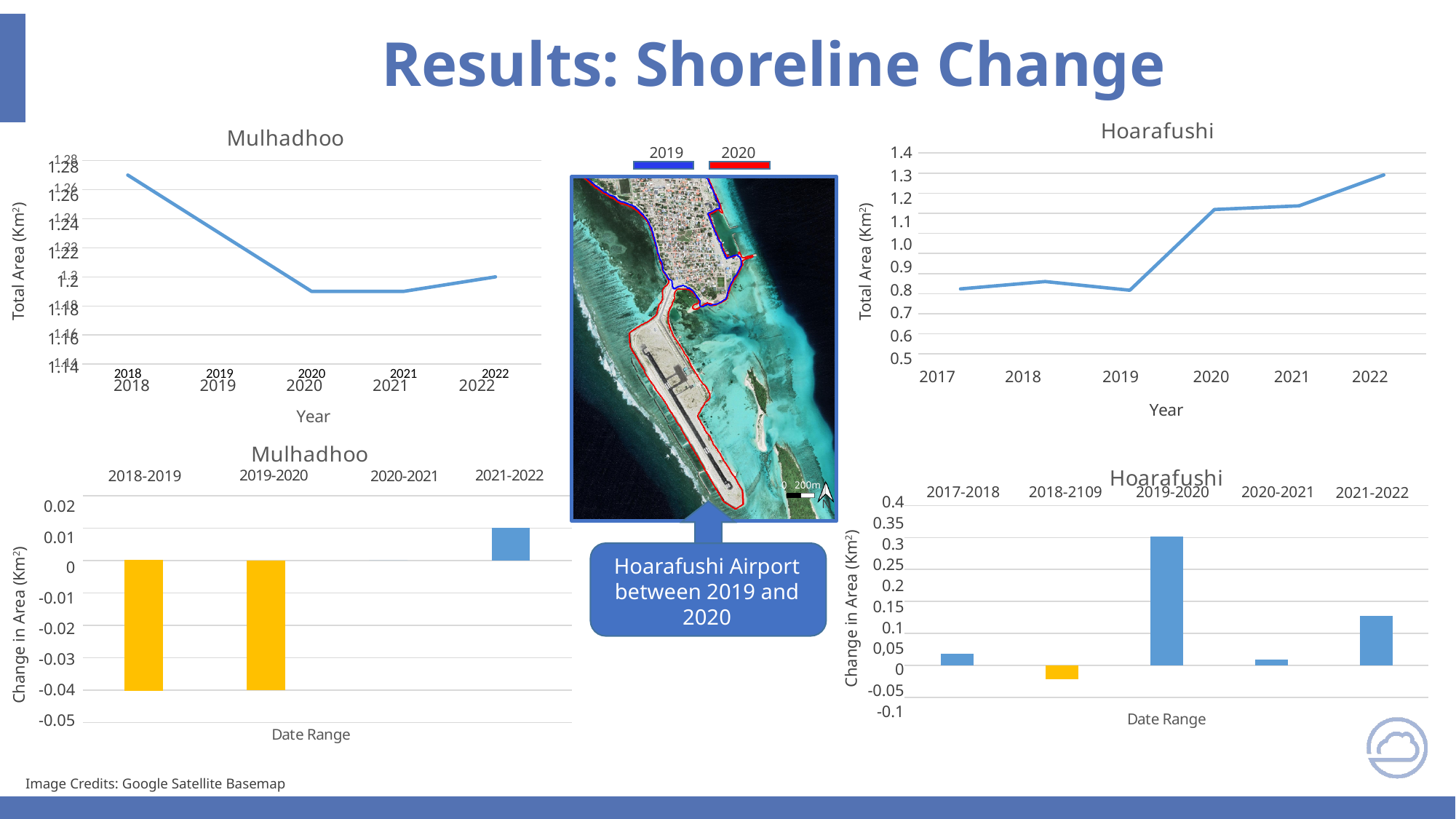
In the bottom-left Mulhadhoo bar chart, is the value for 2018-2019 greater or less than -0.03? less What kind of chart is the top-left Mulhadhoo chart? line chart In the bottom-right Hoarafushi bar chart, which date range has the highest change in area? 2019-2020 In the bottom-right Hoarafushi bar chart, which date range has the lowest change in area? 2018-2109 In the top-right Hoarafushi line chart, is the value for 2017 greater or less than 0.9? less In the top-left Mulhadhoo line chart, which year has the highest total area? 2018 In the bottom-left Mulhadhoo bar chart, which date range has the highest change in area? 2021-2022 In the top-right Hoarafushi line chart, is the value for 2022 greater or less than 1.2? greater What kind of chart is the bottom-right Hoarafushi chart? bar chart How many years are plotted in the top-right Hoarafushi line chart? 6